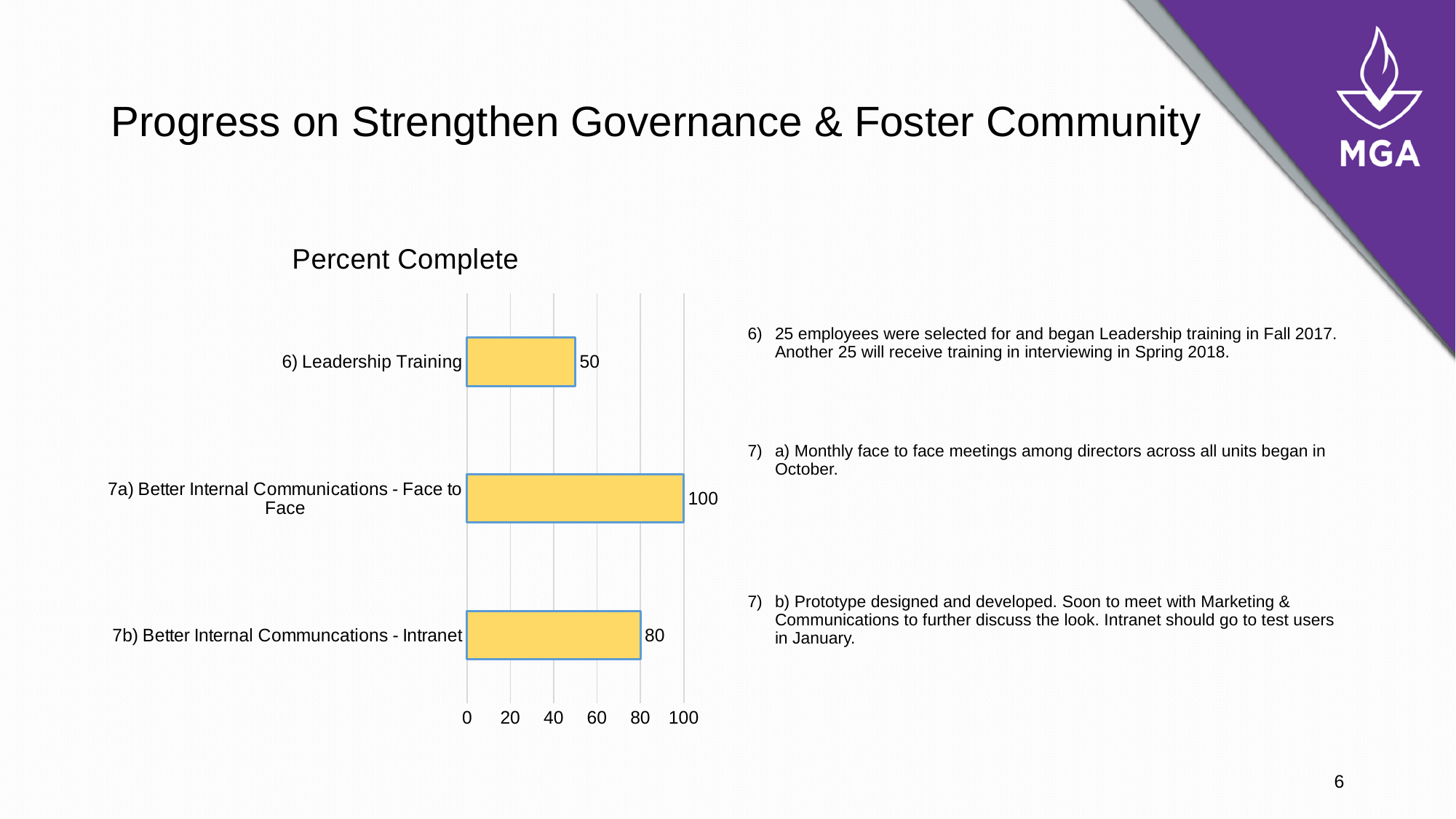
Is the value for 7b) Better Internal Communcations - Intranet greater or less than 60? greater What is the value for 6) Leadership Training? 50 What kind of chart is shown on the slide? bar chart What is the value for 7a) Better Internal Communications - Face to Face? 100 What is the difference between the values for 7b) Better Internal Communcations - Intranet and 6) Leadership Training? 30 What is the title of the chart? Percent Complete Which category has the lowest value? 6) Leadership Training Which category has the highest value? 7a) Better Internal Communications - Face to Face How many categories are shown in the chart? 3 What is the difference between the values for 7a) Better Internal Communications - Face to Face and 6) Leadership Training? 50 Which is larger, the value for 7b) Better Internal Communcations - Intranet or 6) Leadership Training? 7b) Better Internal Communcations - Intranet What is the value for 7b) Better Internal Communcations - Intranet? 80